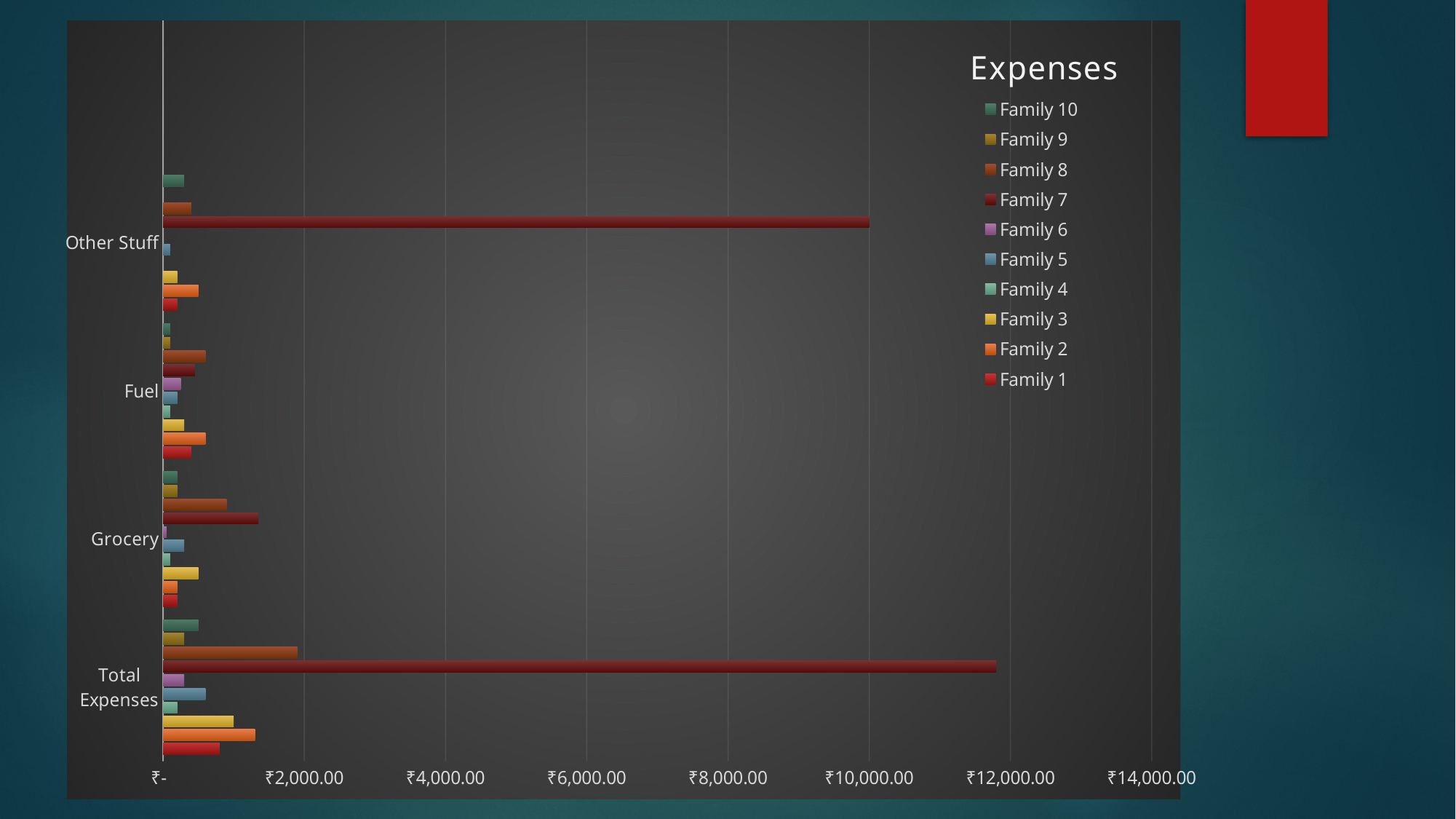
Is the Other Stuff value for Family 7 greater or less than ₹8,000.00? greater How many expense categories are shown on the vertical axis? 4 What is the title of the chart? Expenses Which family has the highest Total Expenses? Family 7 Which family has the highest value for Grocery? Family 7 What kind of chart is shown on the slide? bar chart Is the Total Expenses value for Family 7 greater or less than ₹10,000.00? greater Is the Total Expenses value for Family 8 greater or less than ₹4,000.00? less Which has the larger Grocery value, Family 3 or Family 1? Family 3 How many series does the legend list? 10 Which family has the highest value for Other Stuff? Family 7 Which has the larger Total Expenses, Family 3 or Family 4? Family 3